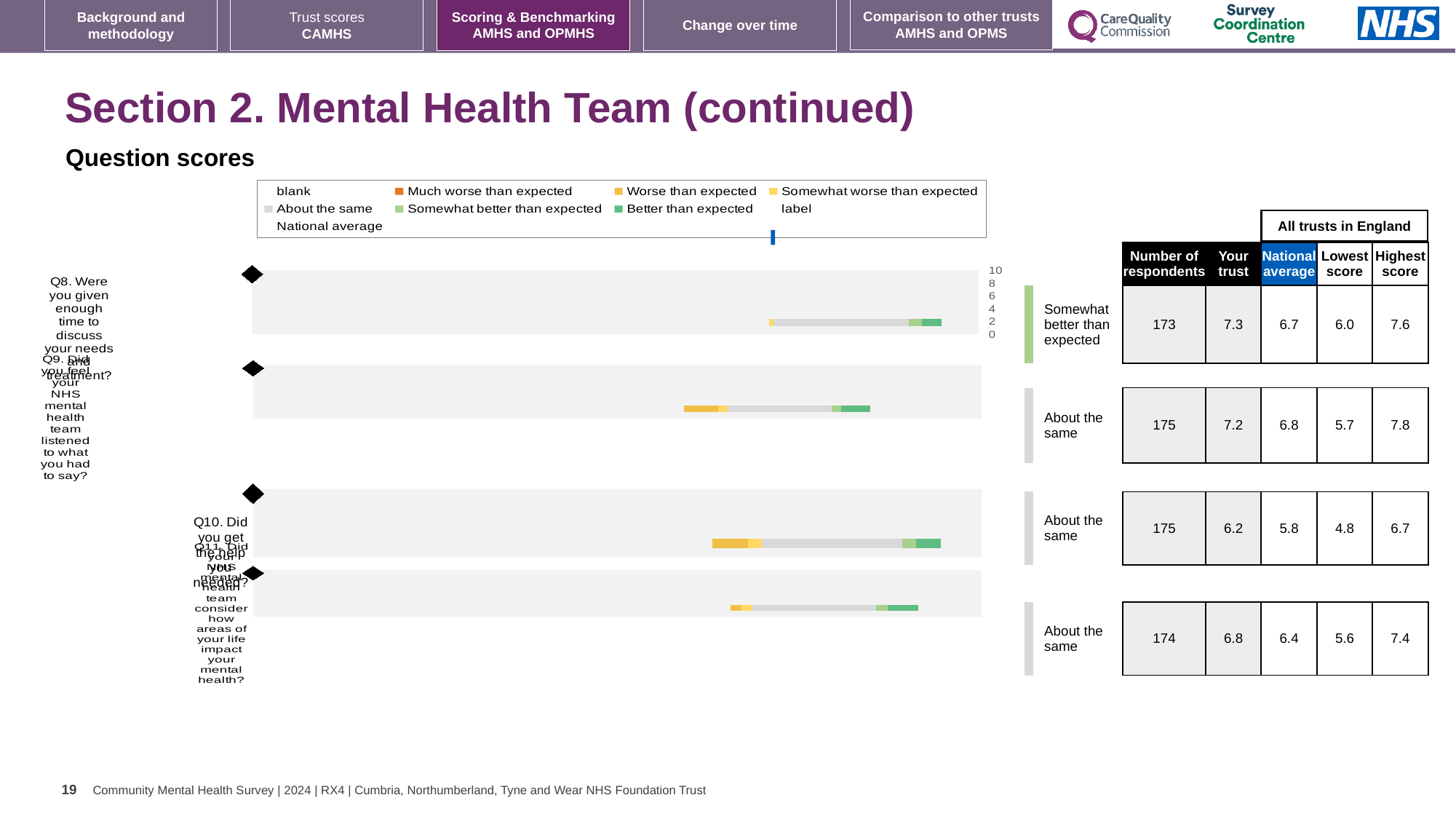
How many respondents answered Q9? 175 Which question has the lowest 'Your trust' score? Q10 What colour represents 'Better than expected' in the chart legend? green How many questions (categories) are plotted in the question scores chart? 4 Is the 'Your trust' score for Q9 larger than the national average for Q9? Yes What kind of chart is used to show the question scores? bar chart How many entries does the legend of the question scores chart list? 9 What colour represents 'Much worse than expected' in the chart legend? orange What is the 'Your trust' score for Q8 (Were you given enough time to discuss your needs and treatment?)? 7.3 What is the difference between the 'Your trust' score and the national average for Q11? 0.4 Which question has the highest 'Your trust' score? Q8 What is the national average score for Q10 (Did you get the help you needed?)? 5.8